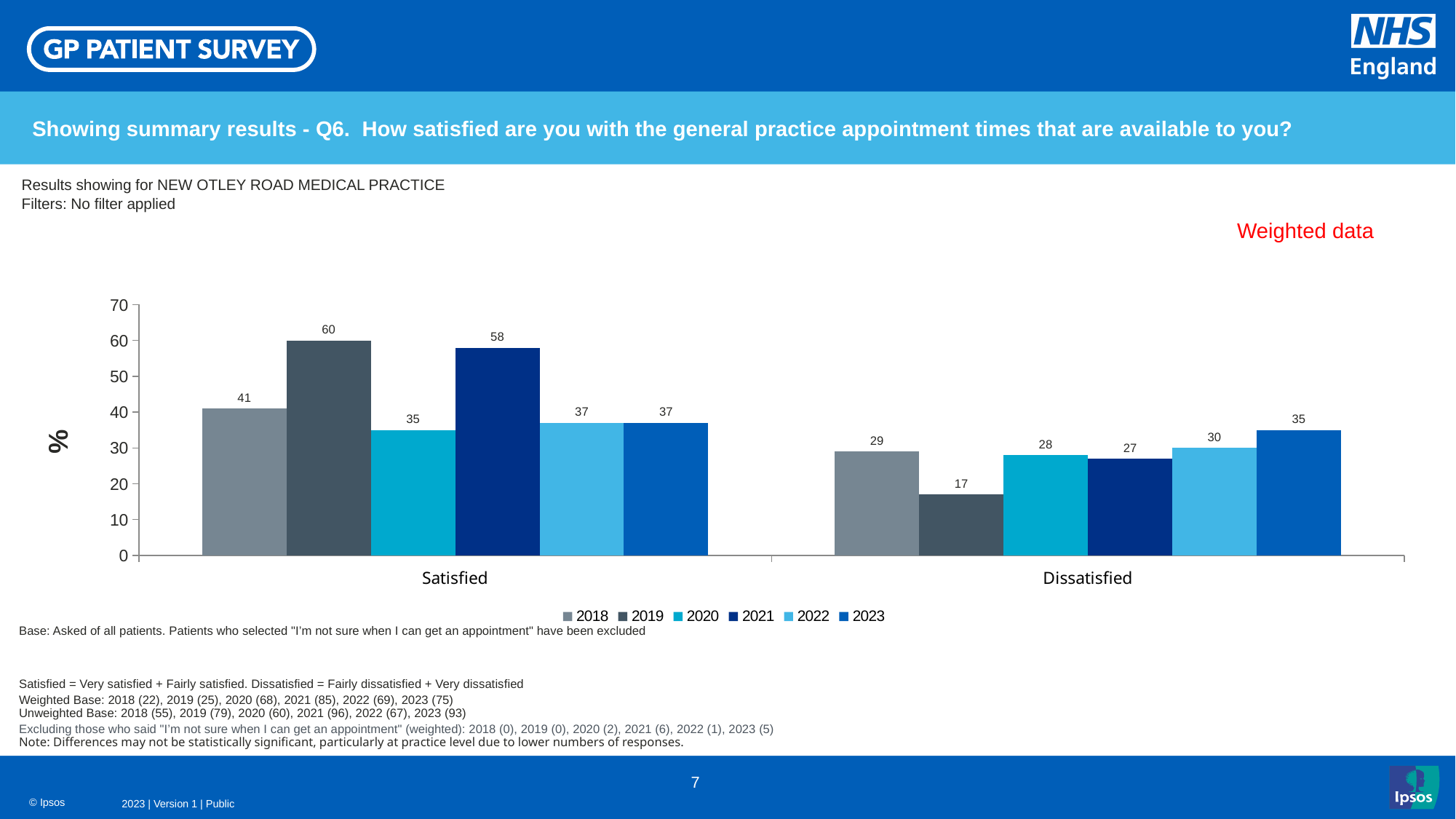
Which year has the lowest value in the Dissatisfied category? 2019 What is the value for 2019 in the Satisfied category? 60 How many series does the legend list? 6 What is the difference between the 2019 and 2020 values in the Satisfied category? 25 What kind of chart is shown on the slide? Bar chart How many categories are shown on the x axis? 2 What label is shown on the y axis? % Which is larger: the 2018 value for Satisfied or the 2018 value for Dissatisfied? Satisfied What is the value for 2021 in the Satisfied category? 58 What is the value for 2023 in the Dissatisfied category? 35 What is the difference between the 2023 and 2022 values in the Dissatisfied category? 5 Which year has the highest value in the Satisfied category? 2019